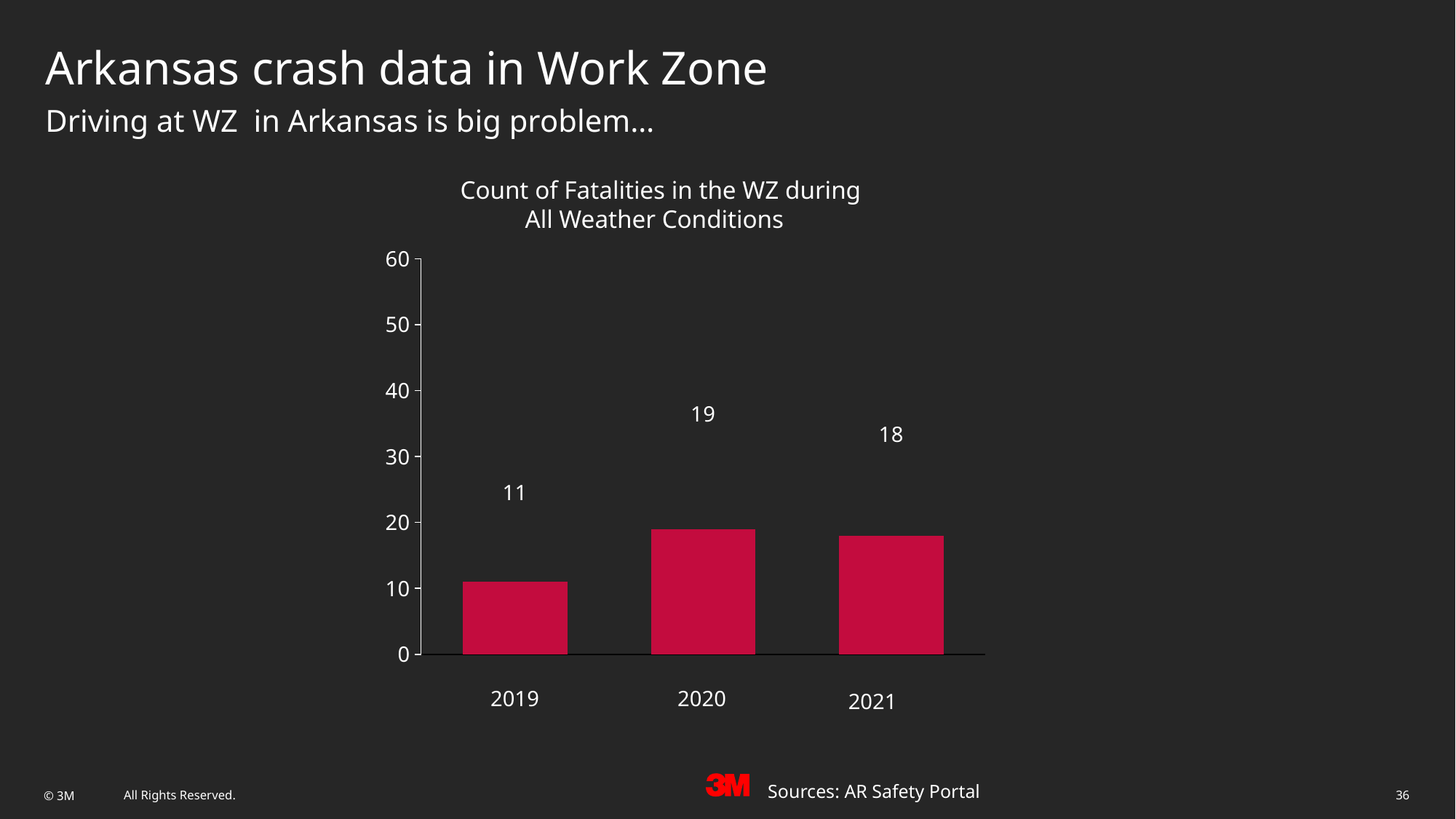
How many years are shown on the chart? 3 Which year has a larger fatality count, 2019 or 2021? 2021 What is the count of fatalities in the WZ for 2021? 18 What is the difference between the fatality counts for 2020 and 2021? 1 Which year has the lowest count of fatalities in the WZ? 2019 What kind of chart is shown on the slide? Bar chart Is the value for 2020 greater or less than 10? greater What is the difference between the fatality counts for 2020 and 2019? 8 What is the count of fatalities in the WZ for 2019? 11 What is the title of the chart? Count of Fatalities in the WZ during All Weather Conditions What is the count of fatalities in the WZ for 2020? 19 Which year has the highest count of fatalities in the WZ? 2020